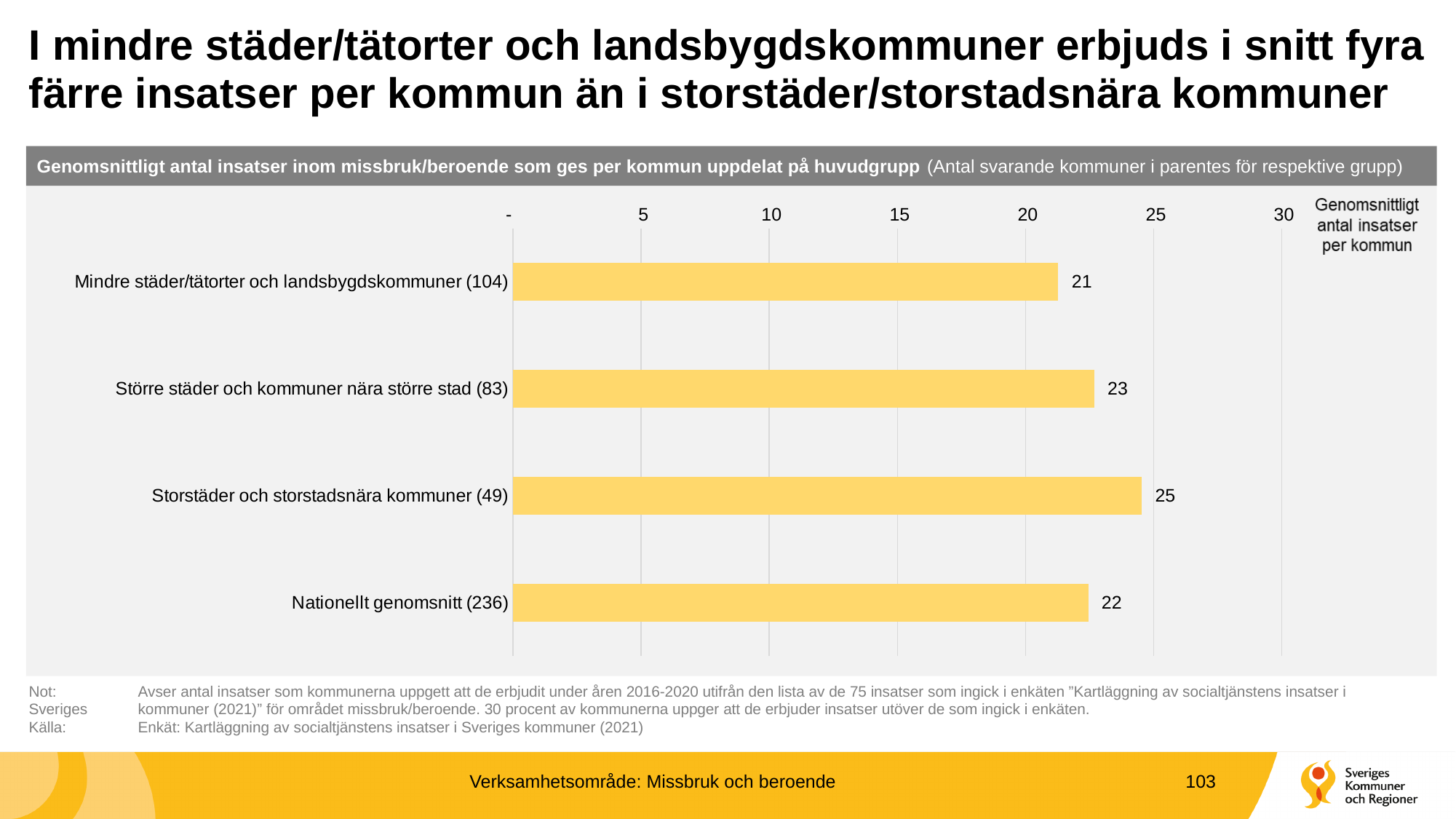
Is the value for Storstäder och storstadsnära kommuner (49) greater or less than 20? greater Which is larger: the value for Större städer och kommuner nära större stad (83) or Nationellt genomsnitt (236)? Större städer och kommuner nära större stad (83) What is the value for Storstäder och storstadsnära kommuner (49)? 25 Which category has the lowest value? Mindre städer/tätorter och landsbygdskommuner (104) What is the value for Mindre städer/tätorter och landsbygdskommuner (104)? 21 What is the label shown at the right end of the x axis? Genomsnittligt antal insatser per kommun What kind of chart is shown on the slide? bar chart What is the value for Nationellt genomsnitt (236)? 22 Which category has the highest value? Storstäder och storstadsnära kommuner (49) What is the difference between the values for Storstäder och storstadsnära kommuner (49) and Mindre städer/tätorter och landsbygdskommuner (104)? 4 How many categories are shown in the chart? 4 What is the value for Större städer och kommuner nära större stad (83)? 23